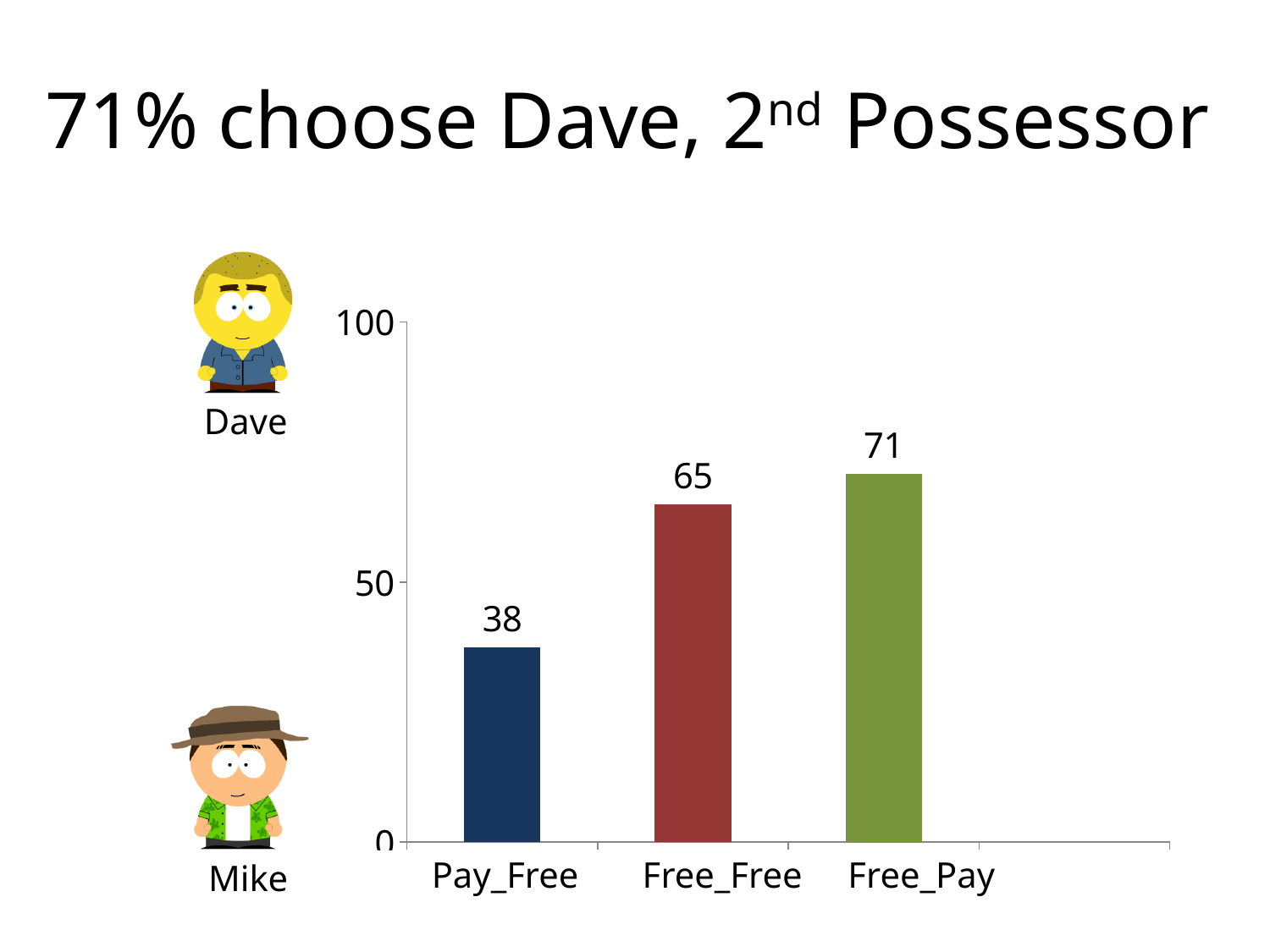
What is the difference between the values for Free_Pay and Free_Free? 6 Which is larger, the value for Free_Free or the value for Pay_Free? Free_Free What is the difference between the values for Free_Pay and Pay_Free? 33 What kind of chart is shown on the slide? bar chart How many categories are shown on the x axis? 3 Is the value for Pay_Free greater or less than 50? less What is the value for Free_Free? 65 Which category has the lowest value? Pay_Free Which category has the highest value? Free_Pay Do the values rise or fall from left to right along the x axis? rise What is the value for Free_Pay? 71 What is the value for Pay_Free? 38